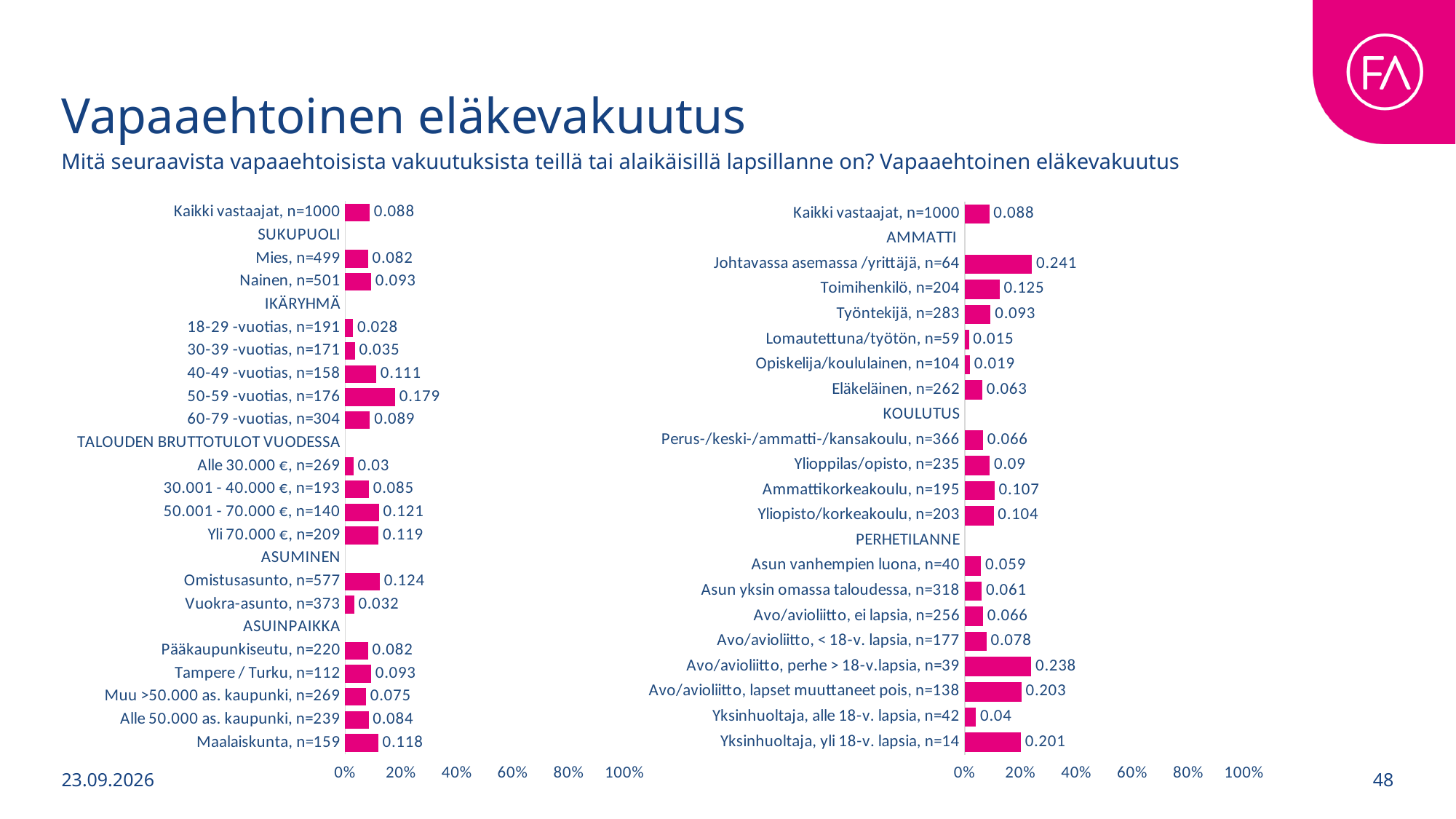
In the left chart, what is the value for Kaikki vastaajat, n=1000? 0.088 In the left chart, which category has the highest value? 50-59 -vuotias, n=176 In the right chart, what is the value for Johtavassa asemassa /yrittäjä, n=64? 0.241 In the right chart, which is larger: the value for Toimihenkilö, n=204 or the value for Työntekijä, n=283? Toimihenkilö, n=204 In the left chart, is the value for Maalaiskunta, n=159 greater or less than 20%? less In the left chart, what is the value for 50-59 -vuotiaat, n=176? 0.179 In the right chart, what is the value for Yksinhuoltaja, yli 18-v. lapsia, n=14? 0.201 In the right chart, which category has the lowest value? Lomautettuna/työtön, n=59 In the left chart, what is the difference between the values for Omistusasunto, n=577 and Vuokra-asunto, n=373? 0.092 In the right chart, what is the difference between the values for Ammattikorkeakoulu, n=195 and Yliopisto/korkeakoulu, n=203? 0.003 What type of chart is shown on the left side of the slide? bar chart In the right chart, is the value for Avo/avioliitto, perhe > 18-v.lapsia, n=39 greater or less than 20%? greater